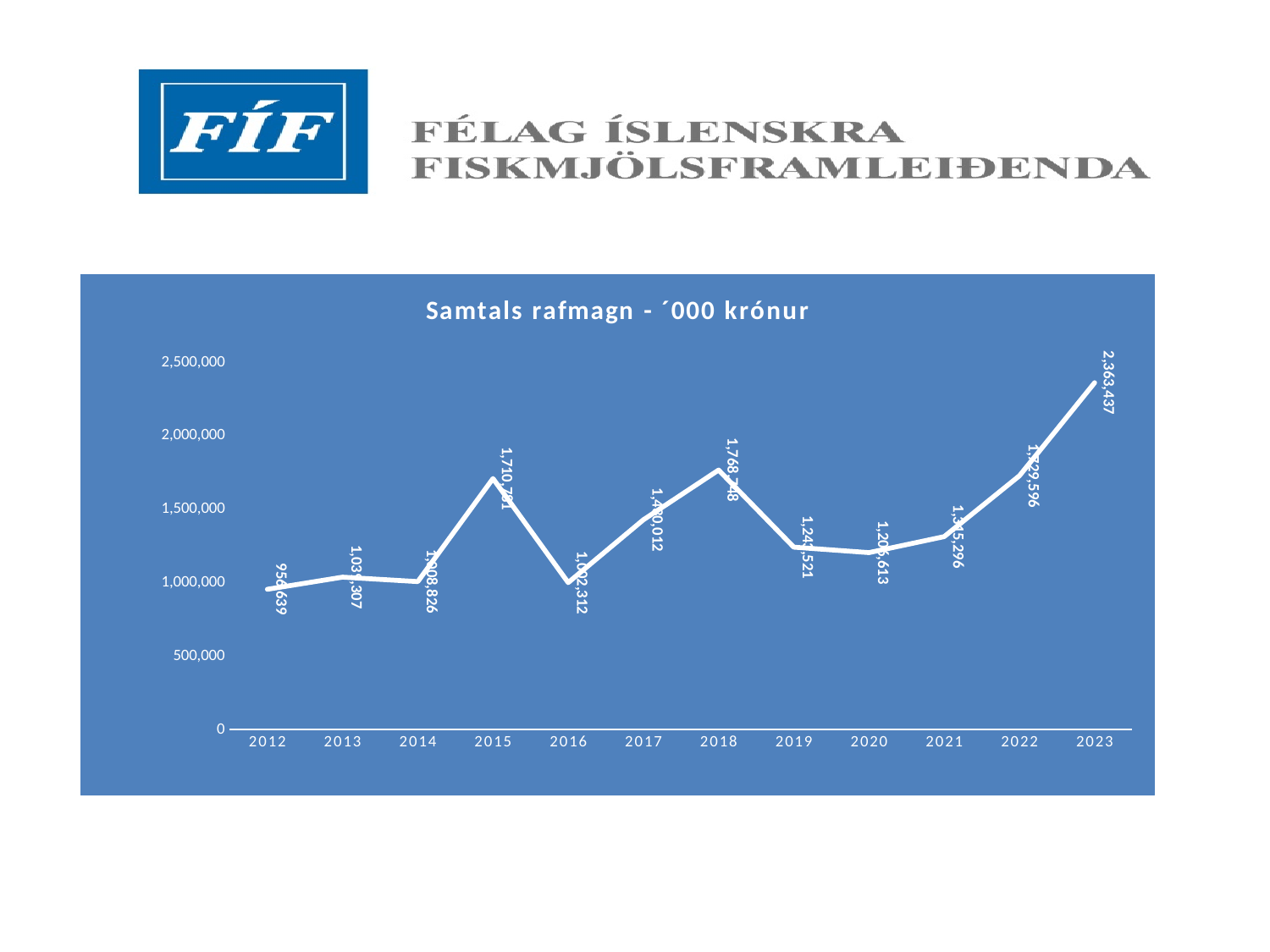
How many years are plotted on the x axis? 12 Which is larger, the value for 2022 or the value for 2021? 2022 Do the values rise or fall from 2020 to 2023? rise Which year has the lowest value? 2012 What is the difference between the values for 2023 and 2012? 1,406,798 What is the value for 2023? 2,363,437 What is the value for 2012? 956,639 What kind of chart is shown on the slide? line chart Is the value for 2019 greater or less than 1,500,000? less Which year has the highest value? 2023 Is the value for 2015 greater or less than 1,500,000? greater Which is larger, the value for 2017 or the value for 2016? 2017